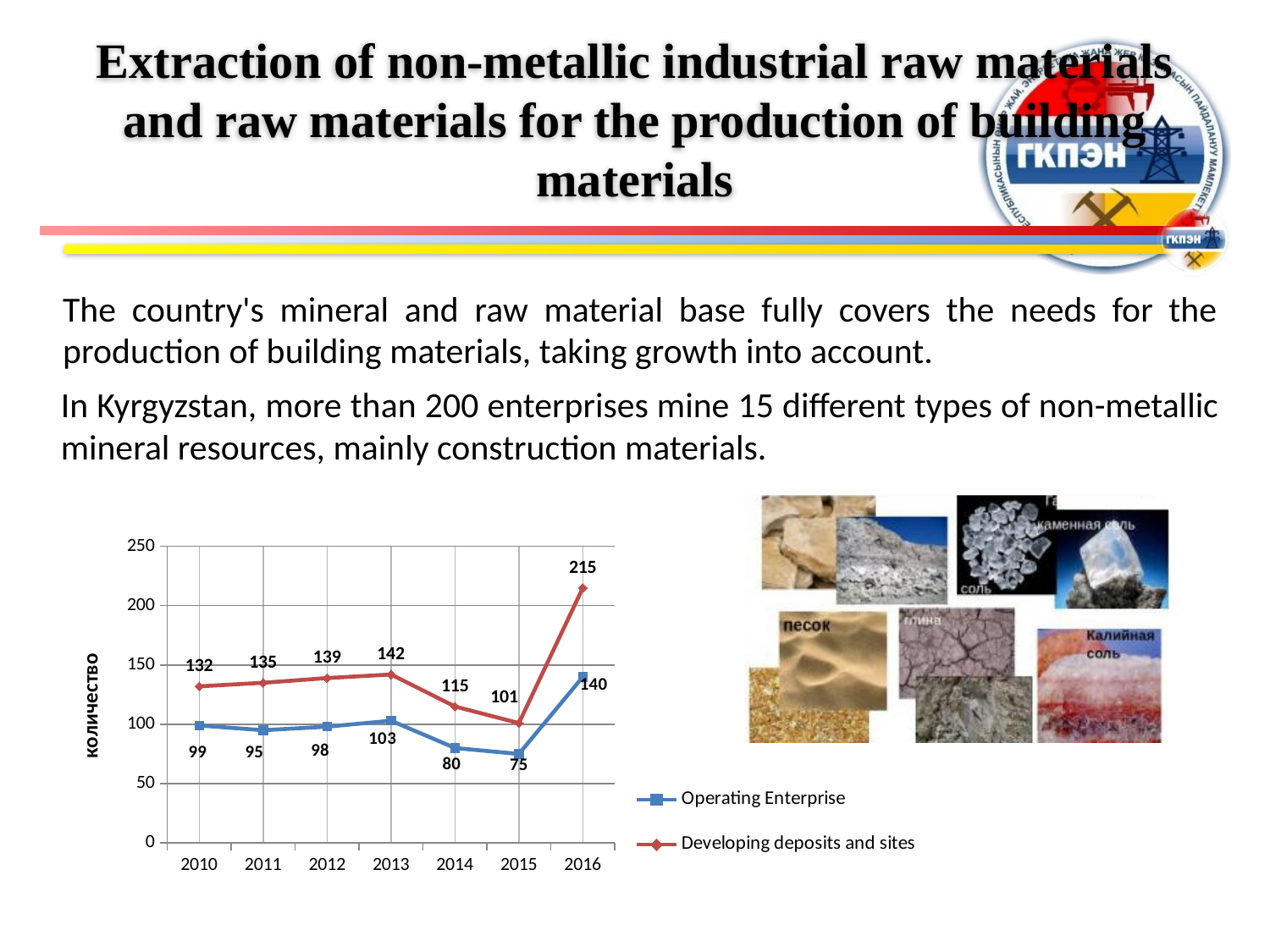
In which year is the value for Operating Enterprise lowest? 2015 What is the value for Operating Enterprise in 2015? 75 How many series does the chart legend list? 2 How many years are shown on the x axis of the chart? 7 Does the value for Operating Enterprise rise or fall from 2015 to 2016? rise What is the value for Operating Enterprise in 2016? 140 In which year is the value for Developing deposits and sites highest? 2016 What is the value for Developing deposits and sites in 2013? 142 What is the label on the vertical axis of the chart? количество What type of chart is shown on the slide? line chart What is the difference between Developing deposits and sites and Operating Enterprise in 2016? 75 Which series has the larger value in 2014, Operating Enterprise or Developing deposits and sites? Developing deposits and sites